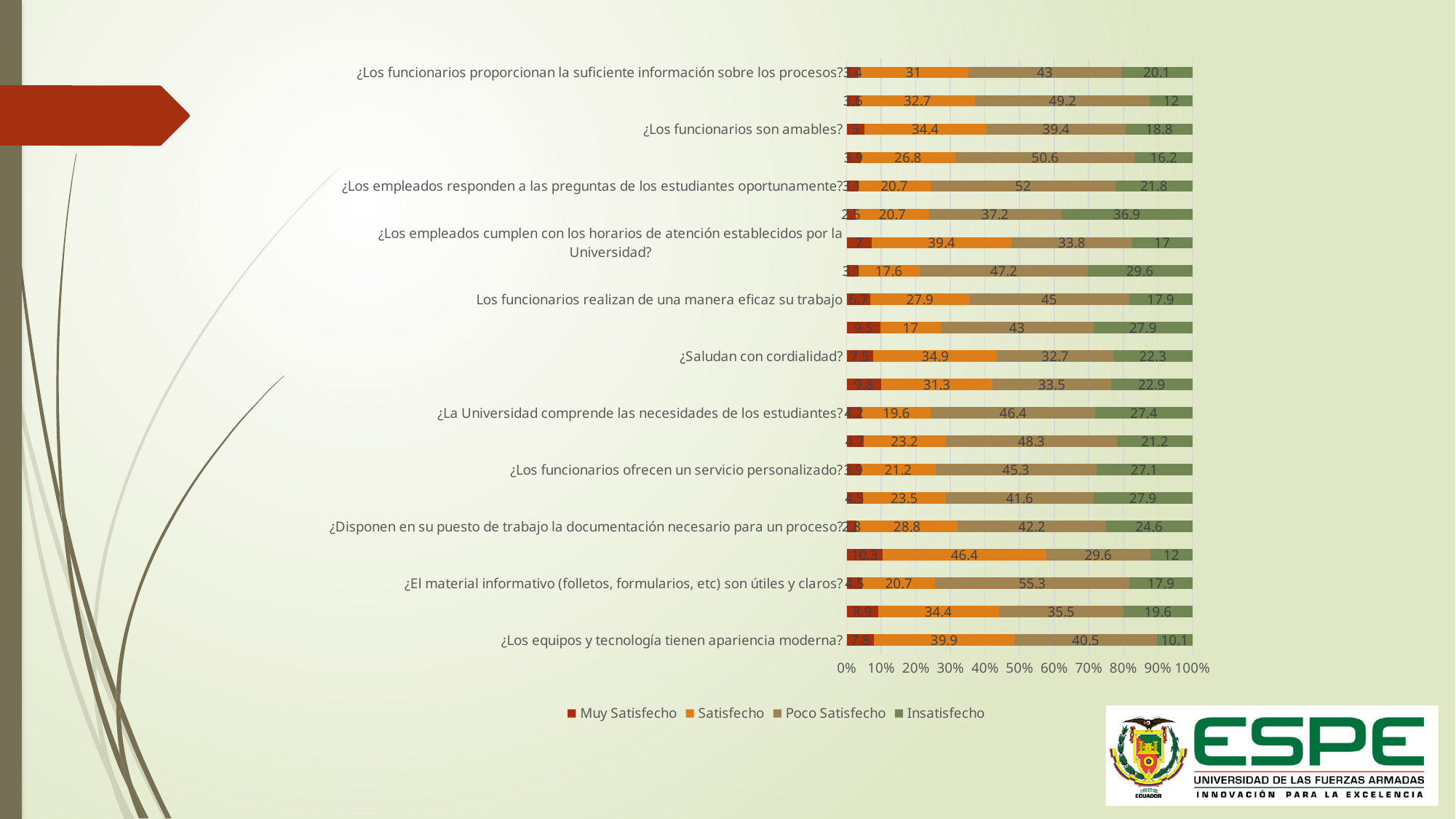
What is the difference between the Satisfecho value for '¿Los equipos y tecnología tienen apariencia moderna?' and the Satisfecho value for '¿Los funcionarios son amables?'? 5.5 Which legend entry is shown in green? Insatisfecho What is the Satisfecho value for '¿Los funcionarios son amables?'? 34.4 What kind of chart is shown on the slide? Stacked bar chart What is the Poco Satisfecho value for '¿El material informativo (folletos, formularios, etc) son útiles y claros?'? 55.3 How many bars are plotted in the chart? 21 Which has the larger Satisfecho value: '¿Los equipos y tecnología tienen apariencia moderna?' or '¿Saludan con cordialidad?'? ¿Los equipos y tecnología tienen apariencia moderna? What is the Insatisfecho value for '¿Los equipos y tecnología tienen apariencia moderna?'? 10.1 Which category has the highest Poco Satisfecho value? ¿El material informativo (folletos, formularios, etc) son útiles y claros? How many series does the legend list? 4 What is the Poco Satisfecho value for '¿Los empleados responden a las preguntas de los estudiantes oportunamente?'? 52 Which category has the lowest Insatisfecho value? ¿Los equipos y tecnología tienen apariencia moderna?